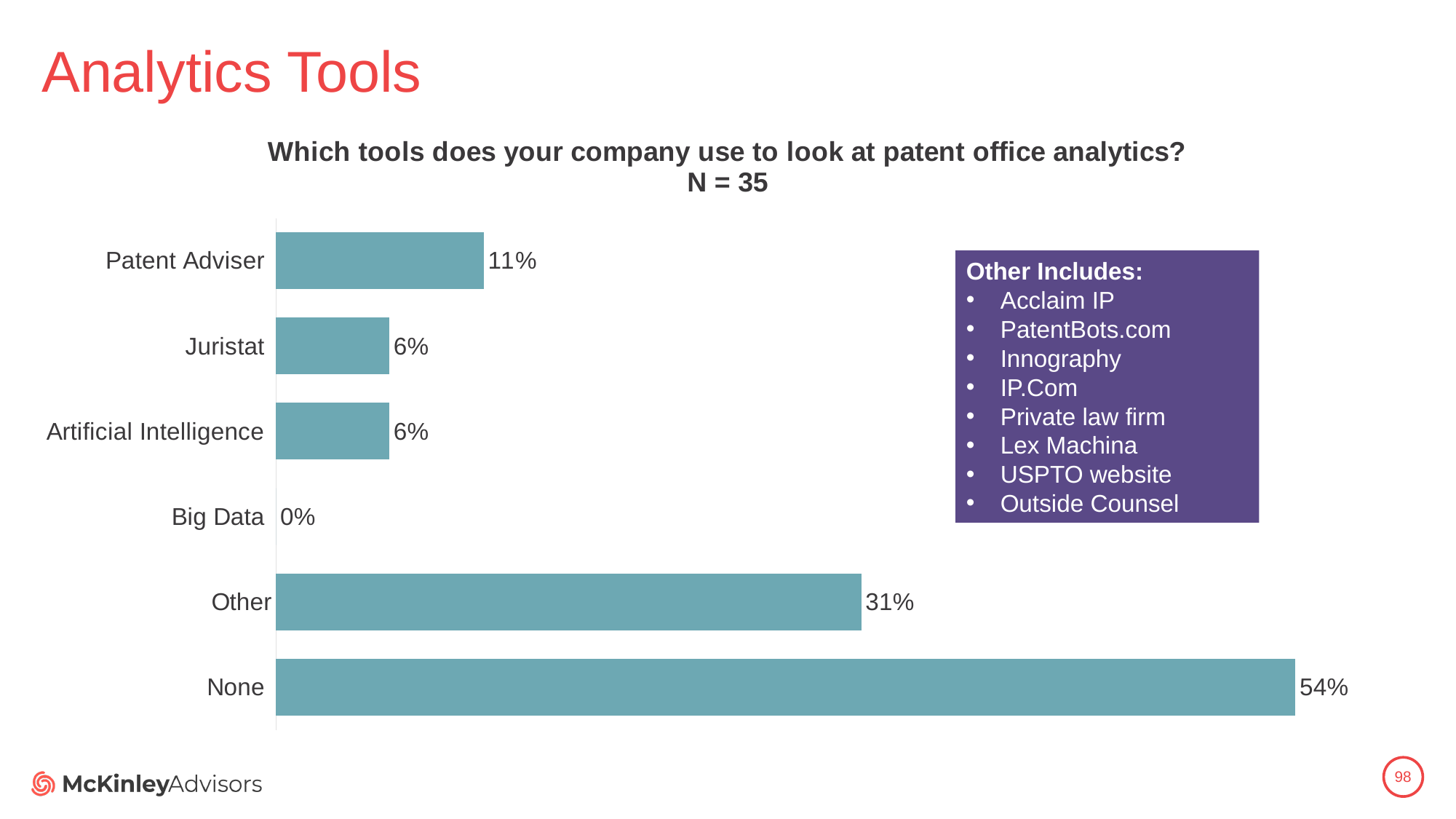
What is the sample size (N) stated in the chart title? 35 Which is larger, the value for Other or the value for Patent Adviser? Other What type of chart is shown on the slide? Bar chart What is the difference between the values for Patent Adviser and Artificial Intelligence? 5% How many categories are shown in the chart? 6 What percentage of respondents use Patent Adviser? 11% What percentage is shown for Big Data? 0% Which category has the highest value? None What is the value shown for Juristat? 6% Which category has the lowest value? Big Data What is the value for the Other category? 31% What is the difference between the values for None and Other? 23%